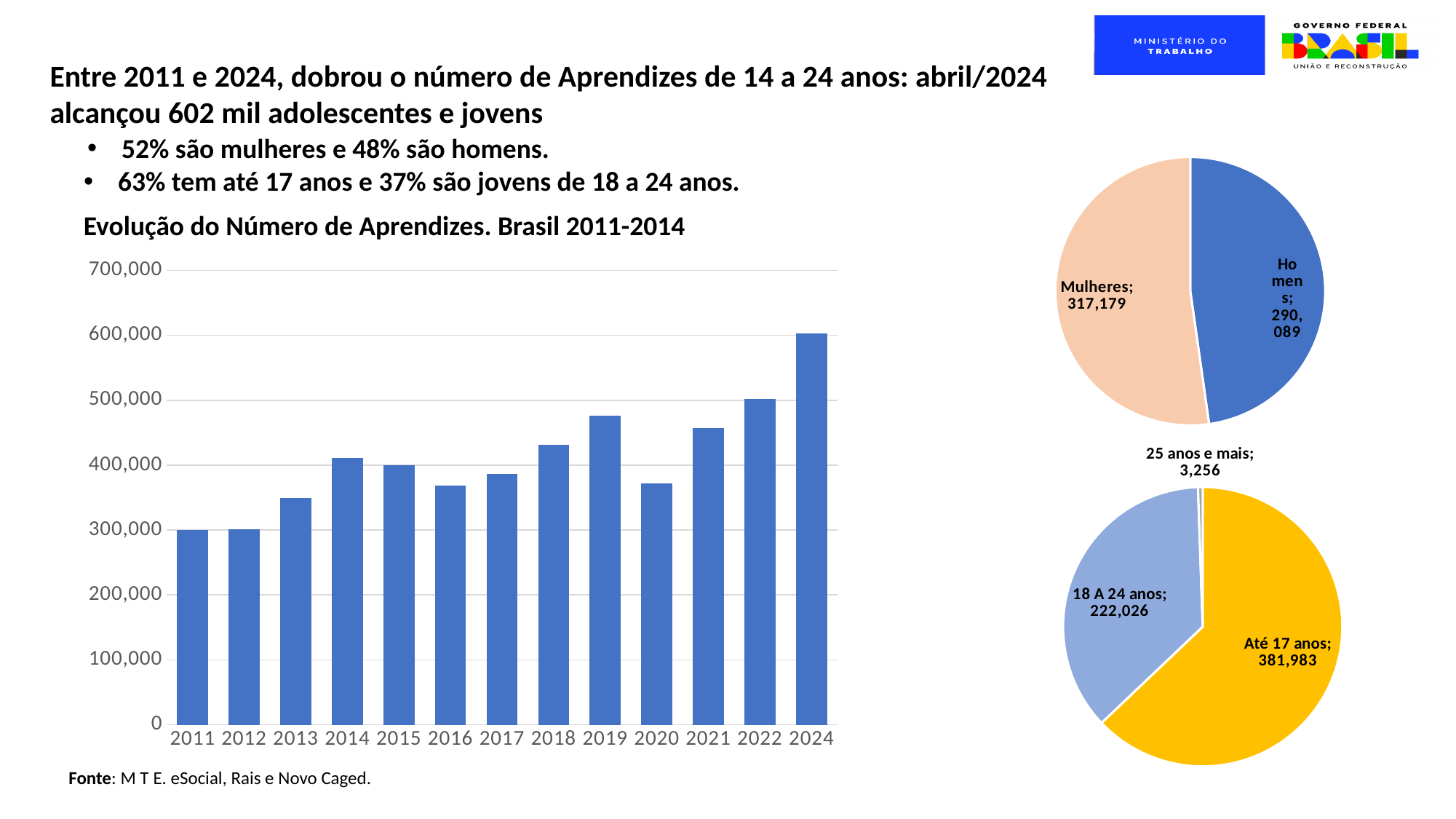
In the bar chart 'Evolução do Número de Aprendizes. Brasil 2011-2014', which year has the highest value? 2024 In the bar chart 'Evolução do Número de Aprendizes. Brasil 2011-2014', is the value for 2021 larger or smaller than the value for 2020? larger In the bar chart 'Evolução do Número de Aprendizes. Brasil 2011-2014', is the value for 2019 greater or less than 500,000? less In the bottom pie chart on the right (age groups), what is the value for '18 A 24 anos'? 222,026 How many years (bars) are shown in the bar chart 'Evolução do Número de Aprendizes. Brasil 2011-2014'? 13 In the bar chart 'Evolução do Número de Aprendizes. Brasil 2011-2014', is the value for 2014 greater or less than 400,000? greater In the top pie chart on the right (gender), what is the value for Mulheres? 317,179 In the bar chart 'Evolução do Número de Aprendizes. Brasil 2011-2014', do the values generally rise or fall from 2011 to 2024? rise In the top pie chart on the right (gender), what is the difference between Mulheres and Homens? 27,090 In the bar chart 'Evolução do Número de Aprendizes. Brasil 2011-2014', is the value for 2016 greater or less than 400,000? less What kind of chart is 'Evolução do Número de Aprendizes. Brasil 2011-2014'? bar chart In the bottom pie chart on the right (age groups), which slice is the smallest? 25 anos e mais